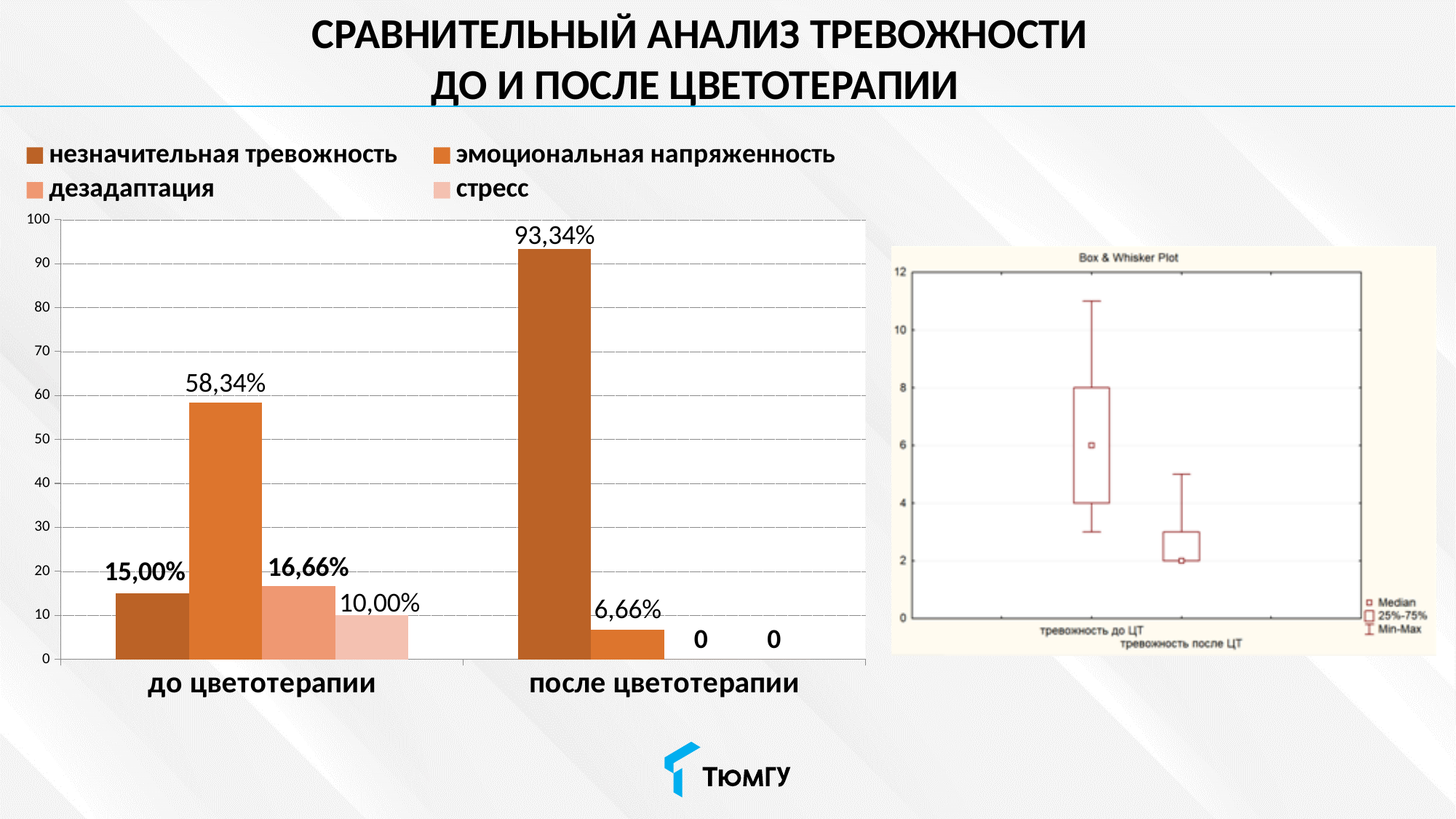
In the bar chart on the left, what is the value for стресс in the до цветотерапии group? 10,00% In the bar chart on the left, which is larger in the до цветотерапии group: эмоциональная напряженность or дезадаптация? эмоциональная напряженность In the bar chart on the left, how many series does the legend list? 4 What kind of chart is shown on the left of the slide? bar chart In the bar chart on the left, how many categories are shown on the x axis? 2 In the bar chart on the left, what is the value for эмоциональная напряженность in the после цветотерапии group? 6,66% In the bar chart on the left, what is the value for незначительная тревожность in the до цветотерапии group? 15,00% In the Box & Whisker Plot on the right, is the median for тревожность до ЦТ greater or less than 4? greater In the bar chart on the left, which series has the highest value in the после цветотерапии group? незначительная тревожность In the bar chart on the left, which series has the lowest value in the до цветотерапии group? стресс In the bar chart on the left, what is the difference between незначительная тревожность after colour therapy (93,34%) and before (15,00%)? 78,34% What is the title of the chart on the right of the slide? Box & Whisker Plot